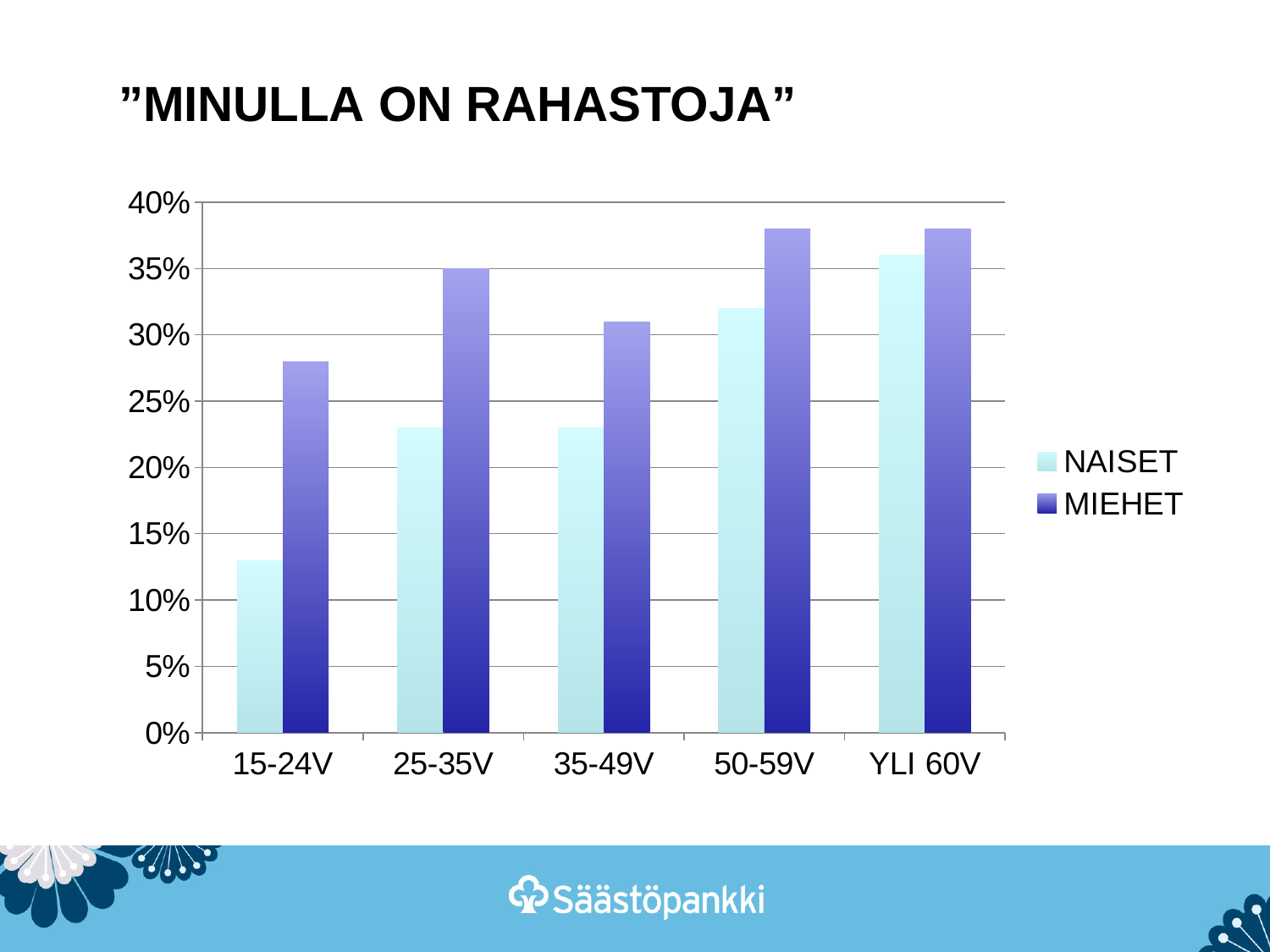
Which age group has the highest value for NAISET? YLI 60V Is the NAISET value for 15-24V greater or less than 15%? less What is the title of the chart? "MINULLA ON RAHASTOJA" Which age group has the lowest value for MIEHET? 15-24V For the 15-24V group, which is larger, NAISET or MIEHET? MIEHET How many age groups are shown on the x axis? 5 How many series does the legend list? 2 Which age group has the lowest value for NAISET? 15-24V What kind of chart is shown on the slide? bar chart Do the NAISET values generally rise or fall from 15-24V to YLI 60V? rise Is the MIEHET value for 50-59V greater or less than 35%? greater Is the NAISET value for 25-35V greater or less than 20%? greater